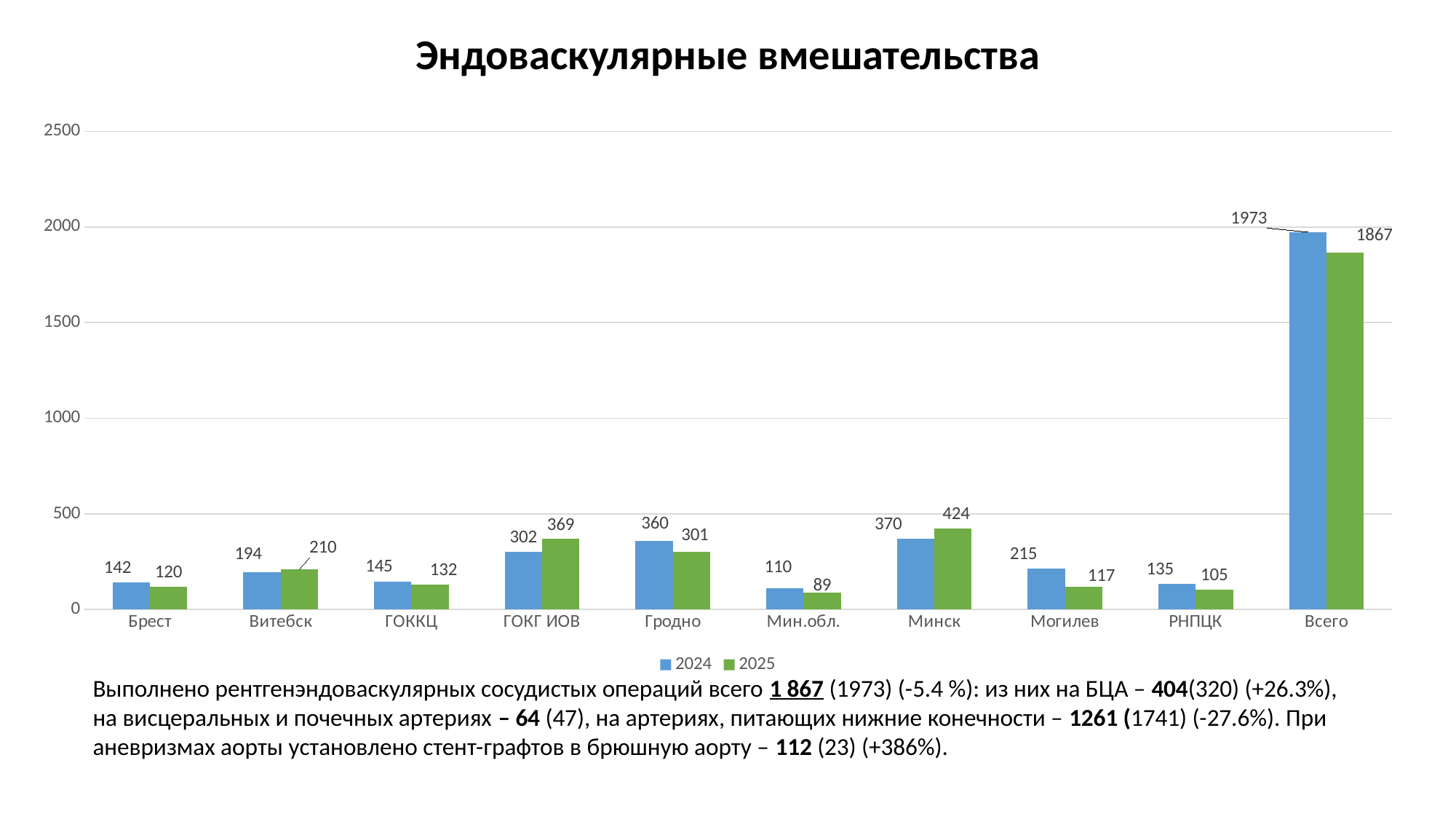
How many categories are shown on the x axis? 10 Which category has the lowest 2024 value? Мин.обл. What is the value for Минск in the 2025 series? 424 Which is larger for Могилев: the 2024 value or the 2025 value? 2024 What is the 2025 value for Мин.обл.? 89 Excluding the Всего category, which category has the highest 2025 value? Минск What is the difference between the 2024 and 2025 values for Всего? 106 What is the value for Гродно in the 2024 series? 360 What is the difference between the 2025 and 2024 values for ГОКГ ИОВ? 67 How many series does the legend list? 2 What type of chart is shown on the slide? bar chart Is the 2024 value for Всего greater or less than 1500? greater